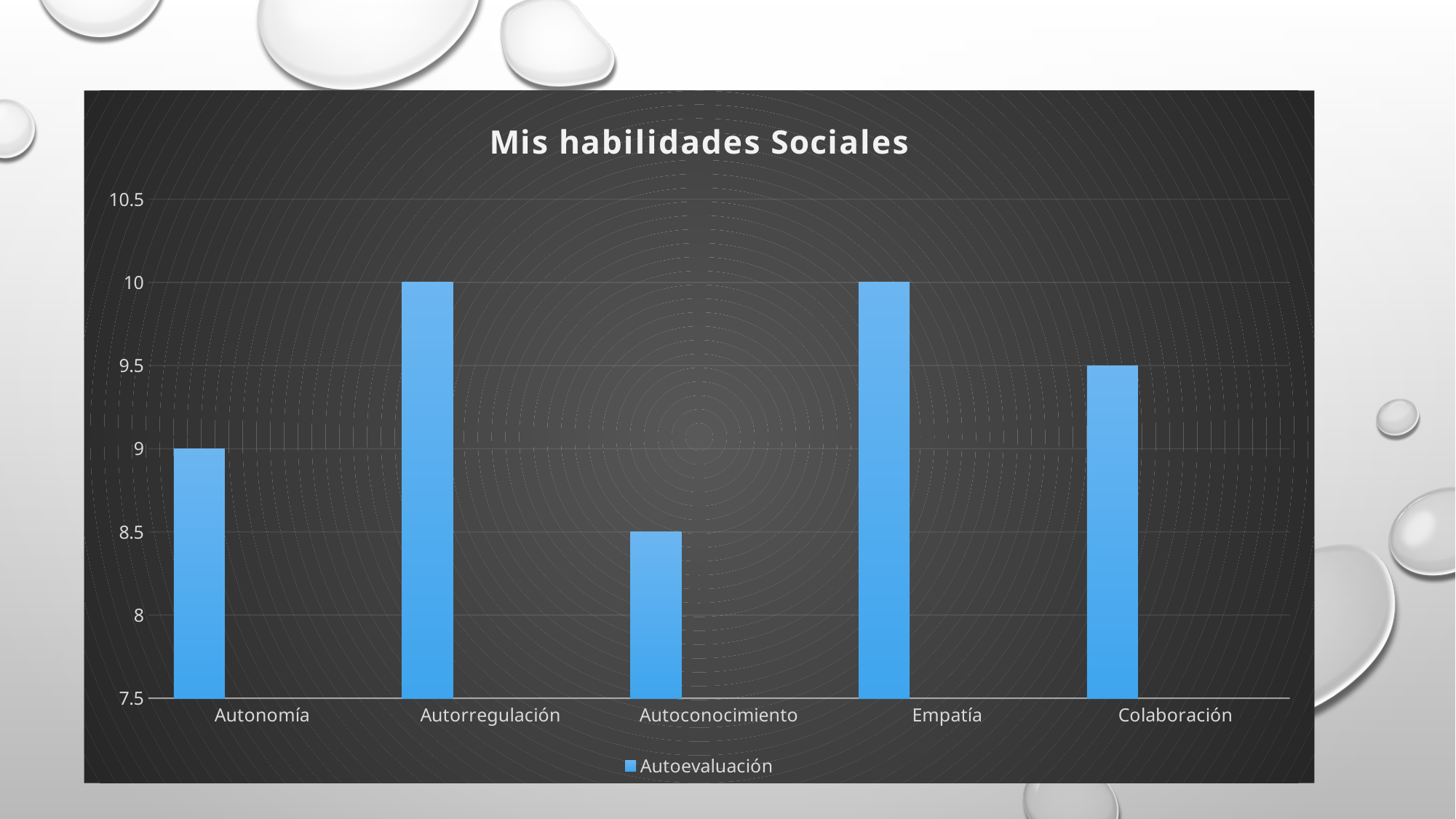
What is the value for Autonomía? 9 What is the name of the series shown in the legend? Autoevaluación What type of chart is shown on the slide? bar chart What is the value for Colaboración? 9.5 What is the value for Autoconocimiento? 8.5 How many categories are shown on the x axis? 5 Which is larger, the value for Colaboración or the value for Autonomía? Colaboración What is the value for Autorregulación? 10 Which category has the lowest value? Autoconocimiento What is the title of the chart? Mis habilidades Sociales What is the difference between the values for Empatía and Autoconocimiento? 1.5 How many series does the legend list? 1